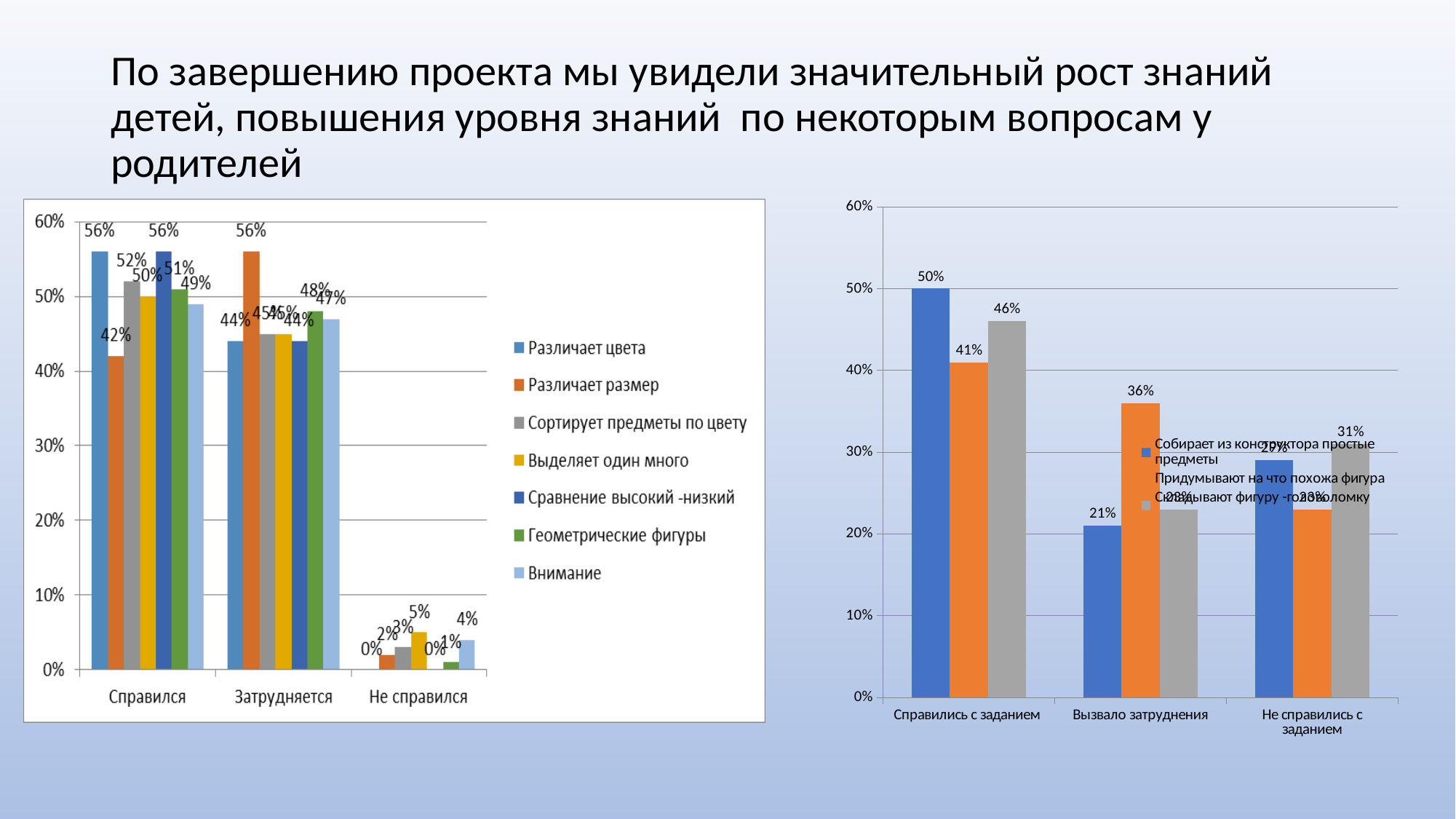
In the right chart, what is the value of the blue series for Справились с заданием? 50% In the right chart, which series has the highest value for Вызвало затруднения? the orange series In the left chart, how many series does the legend list? 7 In the left chart, what is the value for Различает цвета in the Справился category? 56% What type of chart is the right chart? bar chart In the left chart, what is the value for Различает размер in the Затрудняется category? 56% In the right chart, what is the value of the orange series for Вызвало затруднения? 36% In the right chart, is the value of the blue series for Вызвало затруднения greater or less than 30%? less In the left chart, which series has the lowest value in the Справился category? Различает размер In the left chart, what is the difference between Различает цвета and Различает размер in the Справился category? 14% In the left chart, what is the value for Выделяет один много in the Не справился category? 5% In the right chart, how many categories are shown on the x axis? 3